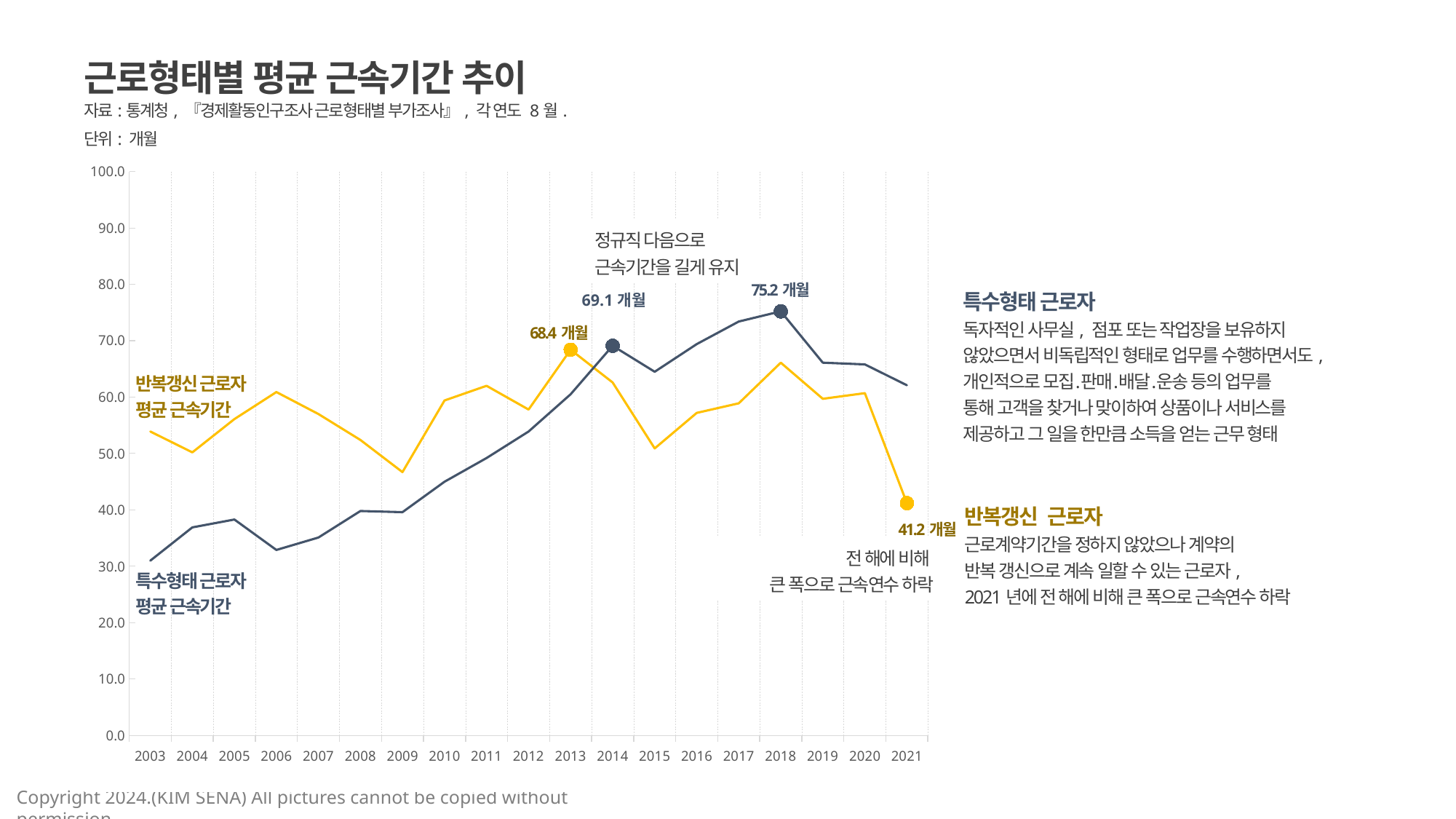
In which year does the 특수형태 근로자 line reach its highest value? 2018 What is the difference between the 특수형태 근로자 values labelled for 2018 and 2014? 6.1 개월 What is the labelled value for 반복갱신 근로자 평균 근속기간 in 2021? 41.2 개월 What is the labelled value for 특수형태 근로자 평균 근속기간 in 2014? 69.1 개월 What kind of chart is shown on the slide? line chart What is the labelled value for 특수형태 근로자 평균 근속기간 in 2018? 75.2 개월 How many years are shown on the x axis of the chart? 19 Is the value for 특수형태 근로자 in 2003 greater or less than 40.0? less What is the labelled value for 반복갱신 근로자 평균 근속기간 in 2013? 68.4 개월 In 2003, which series has the higher value: 반복갱신 근로자 or 특수형태 근로자? 반복갱신 근로자 In which year is the 반복갱신 근로자 line at its lowest value? 2021 How many lines (series) are plotted on the chart? 2